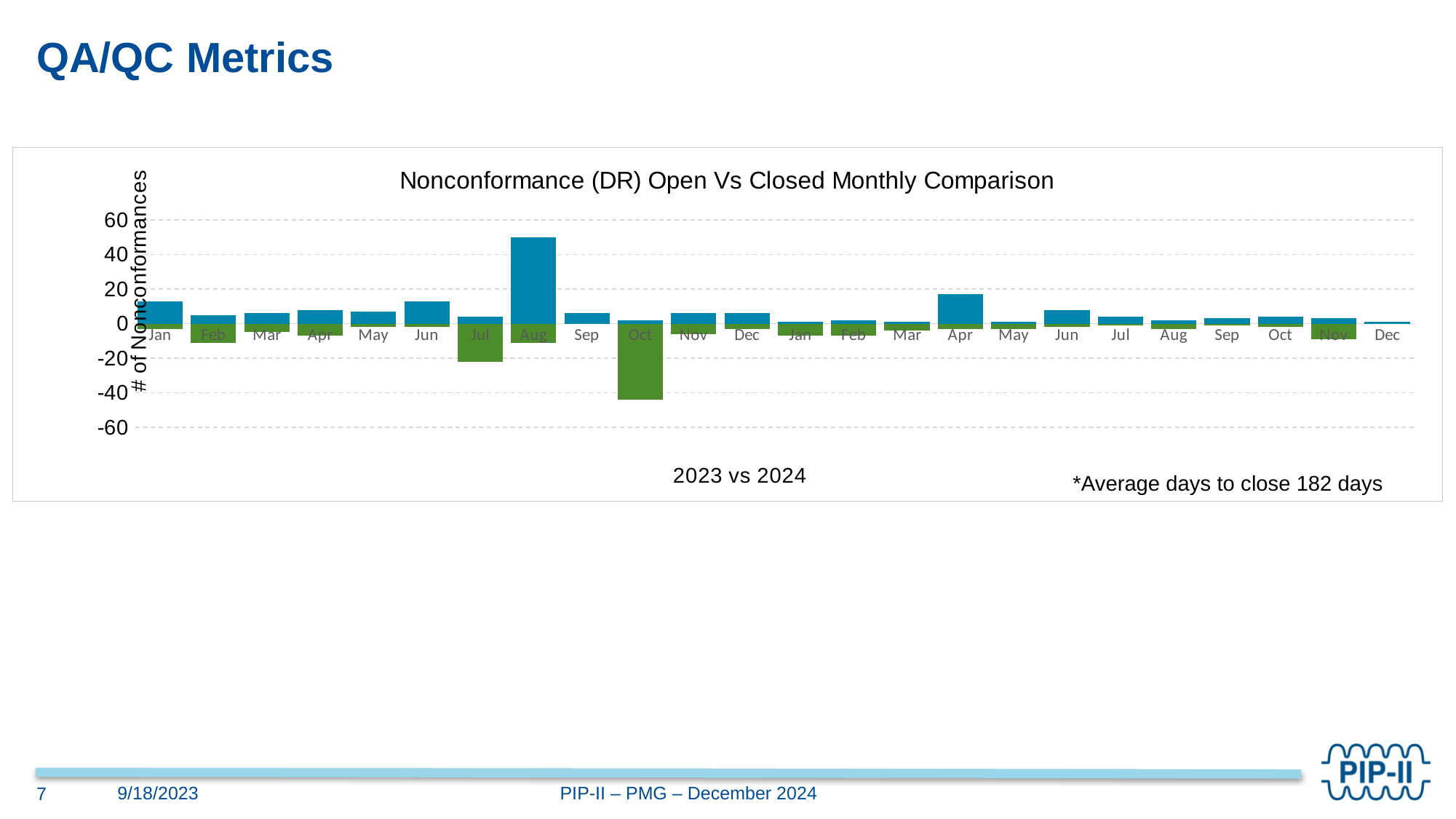
Which month has the longest green (negative) bar in the chart? Oct (2023) Which has the taller blue bar: Aug 2023 (the first Aug) or Apr 2024 (the second Apr)? Aug 2023 Is the blue bar for Aug 2023 (the first Aug) greater or less than 40? greater What is the title of the chart? Nonconformance (DR) Open Vs Closed Monthly Comparison Which has the longer green (negative) bar: Jul 2023 (the first Jul) or Mar 2024 (the second Mar)? Jul 2023 What kind of chart is shown on the slide? bar chart Is the green bar for Oct 2023 (the first Oct) greater or less than -20? less Is the blue bar for Jan 2023 (the first Jan) greater or less than 20? less Which month has the tallest blue (positive) bar in the chart? Aug (2023) What is the label on the vertical axis of the chart? # of Nonconformances How many monthly categories are shown along the x axis of the chart? 24